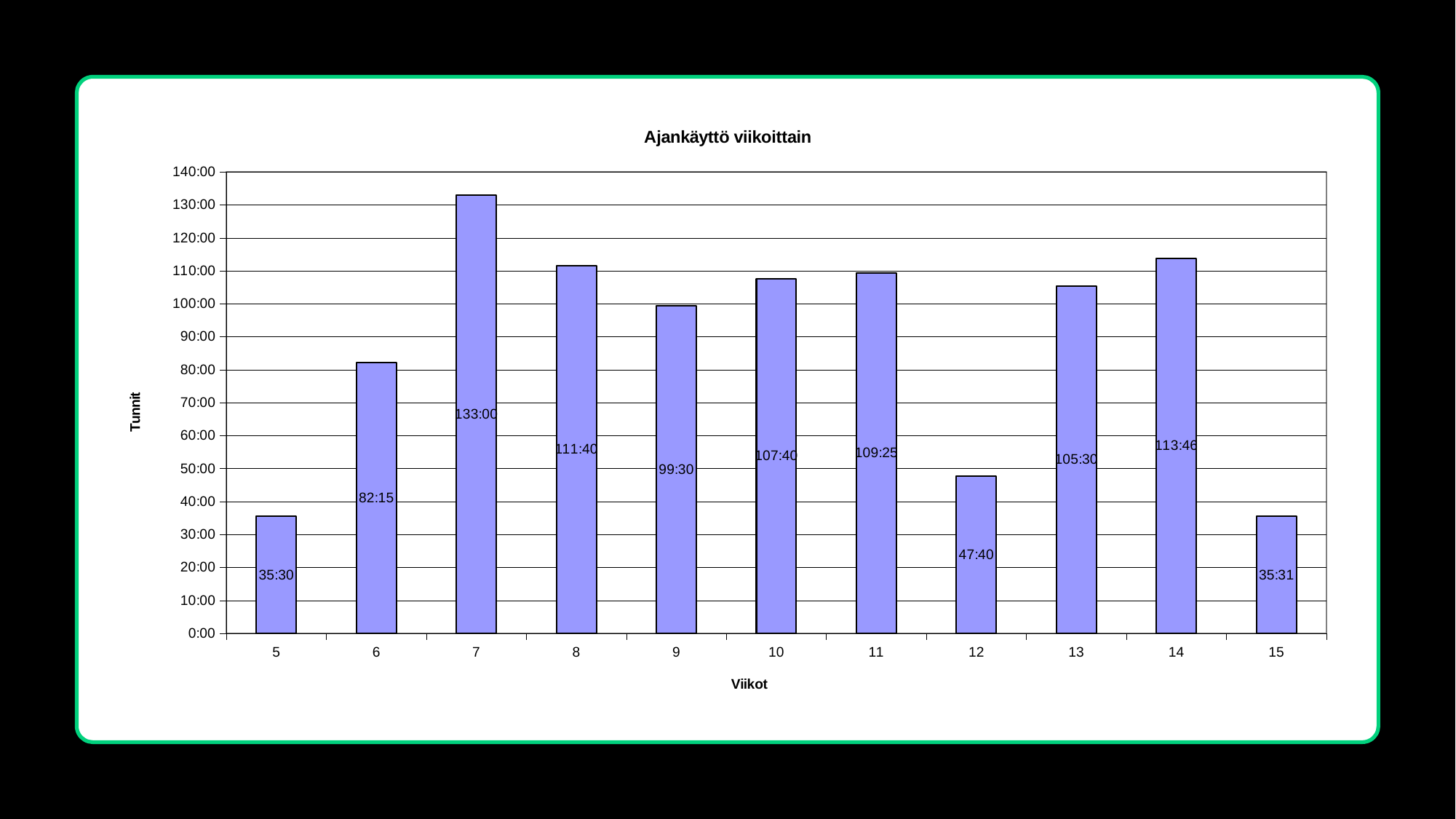
What is the value for week 12? 47:40 Is the value for week 12 greater or less than 50:00? less Is the value for week 7 greater or less than 130:00? greater What is the value for week 14? 113:46 What is the difference between the values for week 7 and week 8? 21:20 What is the value for week 7? 133:00 How many weeks are shown on the x axis? 11 What is the title of the chart? Ajankäyttö viikoittain Which is larger, the value for week 10 or the value for week 11? week 11 What is the difference between the values for week 14 and week 13? 8:16 What kind of chart is shown? bar chart Which week has the highest value? 7